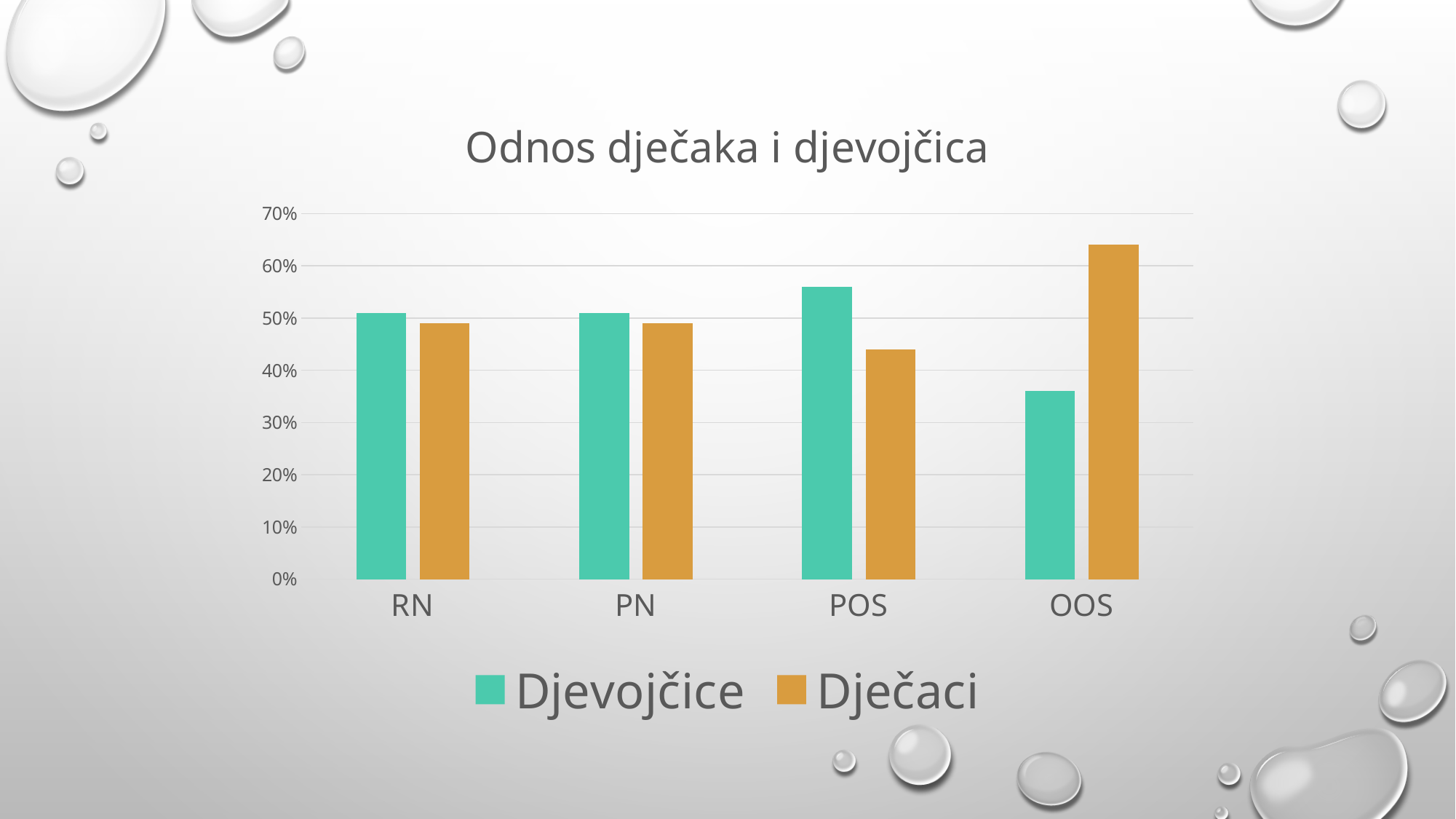
How many series does the legend list? 2 At OOS, which series has the larger value, Djevojčice or Dječaci? Dječaci For which category is the Djevojčice value highest? POS For which category is the Dječaci value highest? OOS How many categories are shown on the x axis? 4 What kind of chart is shown on the slide? bar chart Is the Dječaci value for OOS greater or less than 60%? greater Is the Djevojčice value for OOS greater or less than 40%? less For which category is the Dječaci value lowest? POS For which category is the Djevojčice value lowest? OOS What is the title of the chart? Odnos dječaka i djevojčica Which series is shown in orange? Dječaci